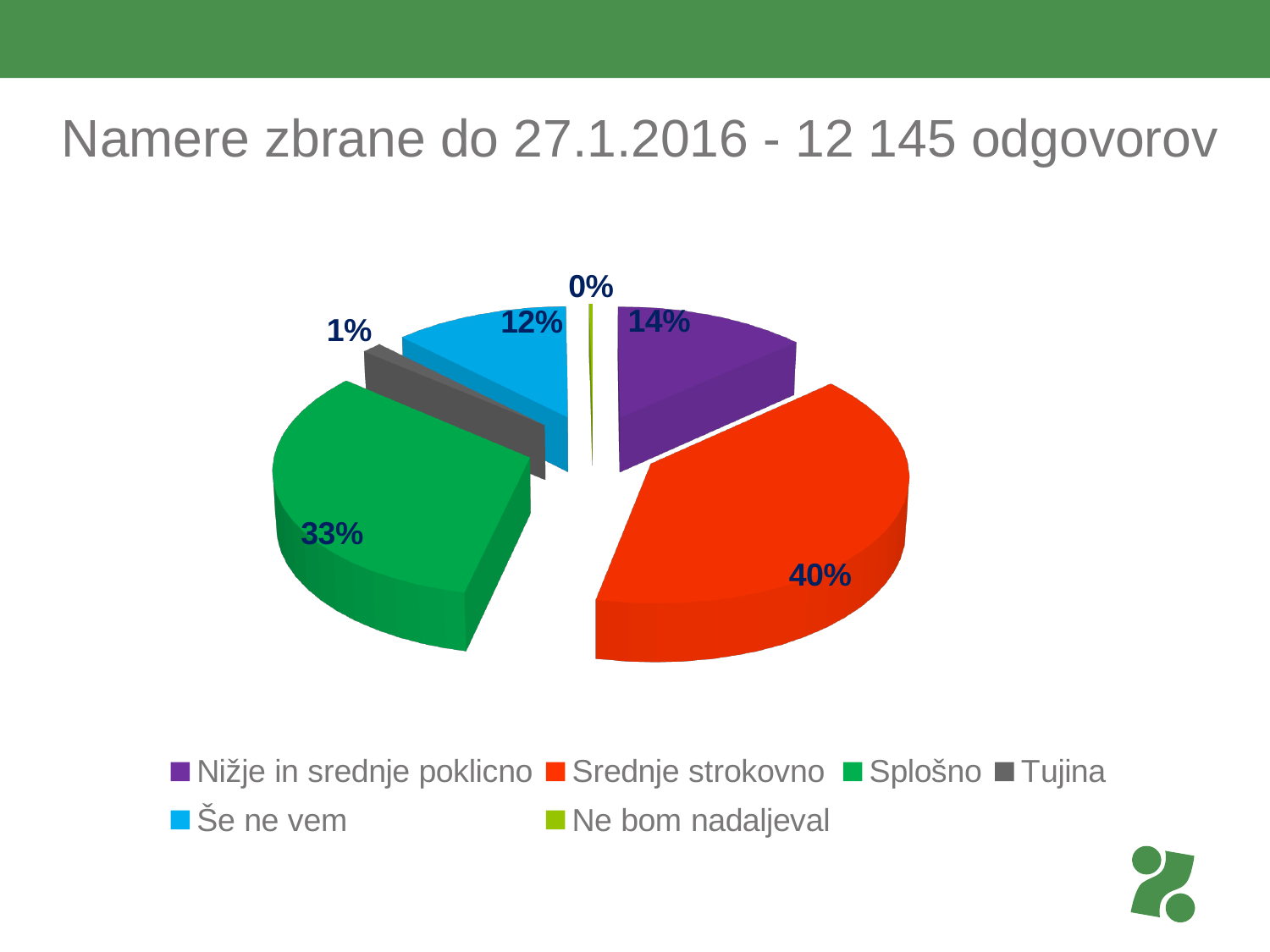
What share of the pie does Srednje strokovno have? 40% Which category has the smallest slice of the pie? Ne bom nadaljeval What share of the pie does Splošno have? 33% Which category has the largest slice of the pie? Srednje strokovno What is the title of the chart slide? Namere zbrane do 27.1.2016 - 12 145 odgovorov What kind of chart is shown on the slide? pie chart What share of the pie does Tujina have? 1% What is the difference in percentage points between Srednje strokovno and Splošno? 7 How many categories does the legend list? 6 Which is larger, the share for Nižje in srednje poklicno or the share for Še ne vem? Nižje in srednje poklicno